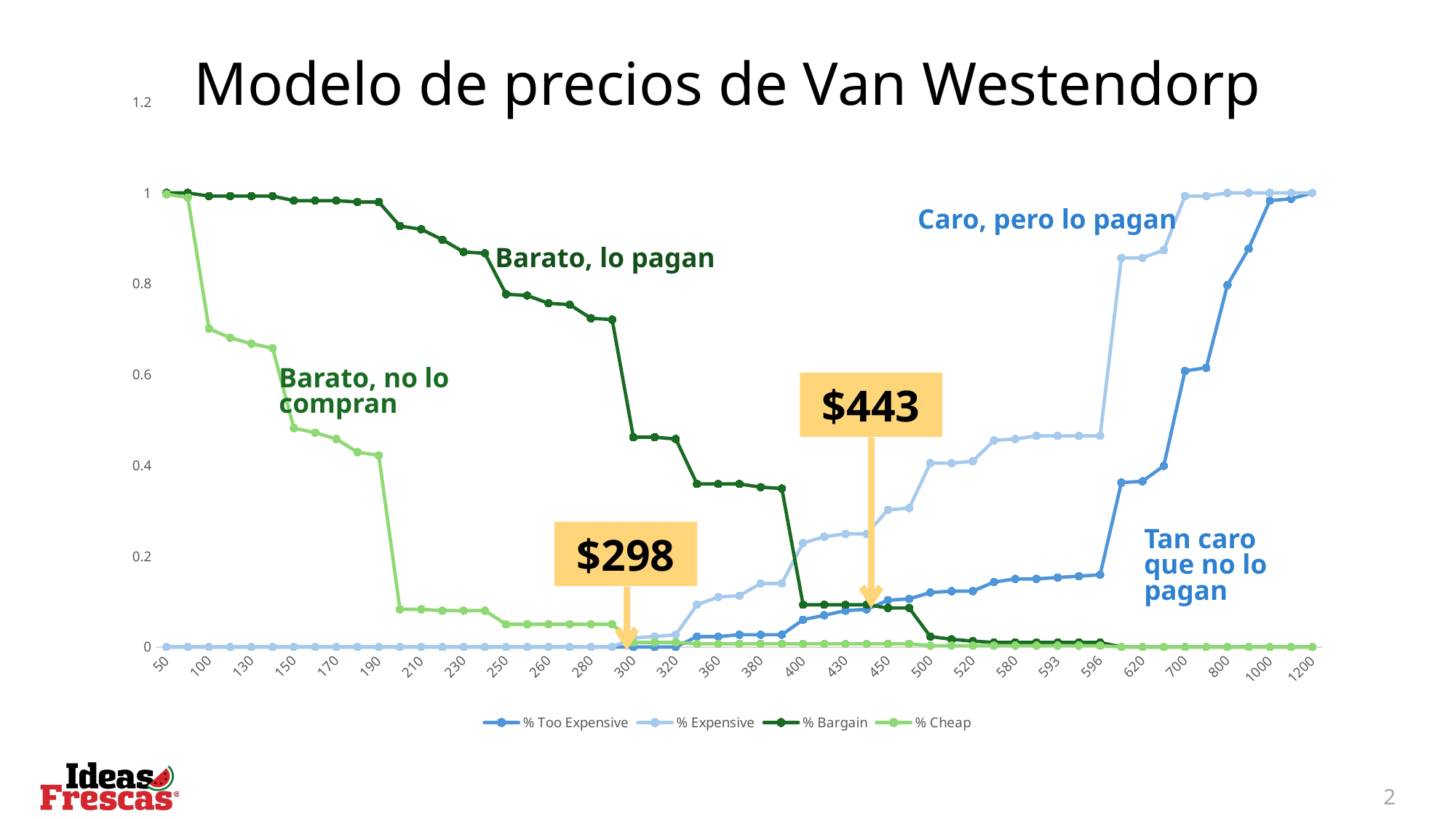
Is the value of % Expensive at the price point 620 greater or less than 0.8? greater What kind of chart is shown on the slide? line chart Does the % Too Expensive series rise or fall as the price increases along the x axis? rise At the price point 300, which is larger: % Bargain or % Cheap? % Bargain What is the value of % Bargain at the price point 1200? 0 How many series does the legend list? 4 Is the value of % Cheap at the price point 150 greater or less than 0.6? less What is the title of the chart? Modelo de precios de Van Westendorp What price is shown in the lower annotation box pointing at the 300 mark on the x axis? $298 What is the value of % Too Expensive at the price point 1200? 1 Is the value of % Too Expensive at the price point 596 greater or less than 0.4? less